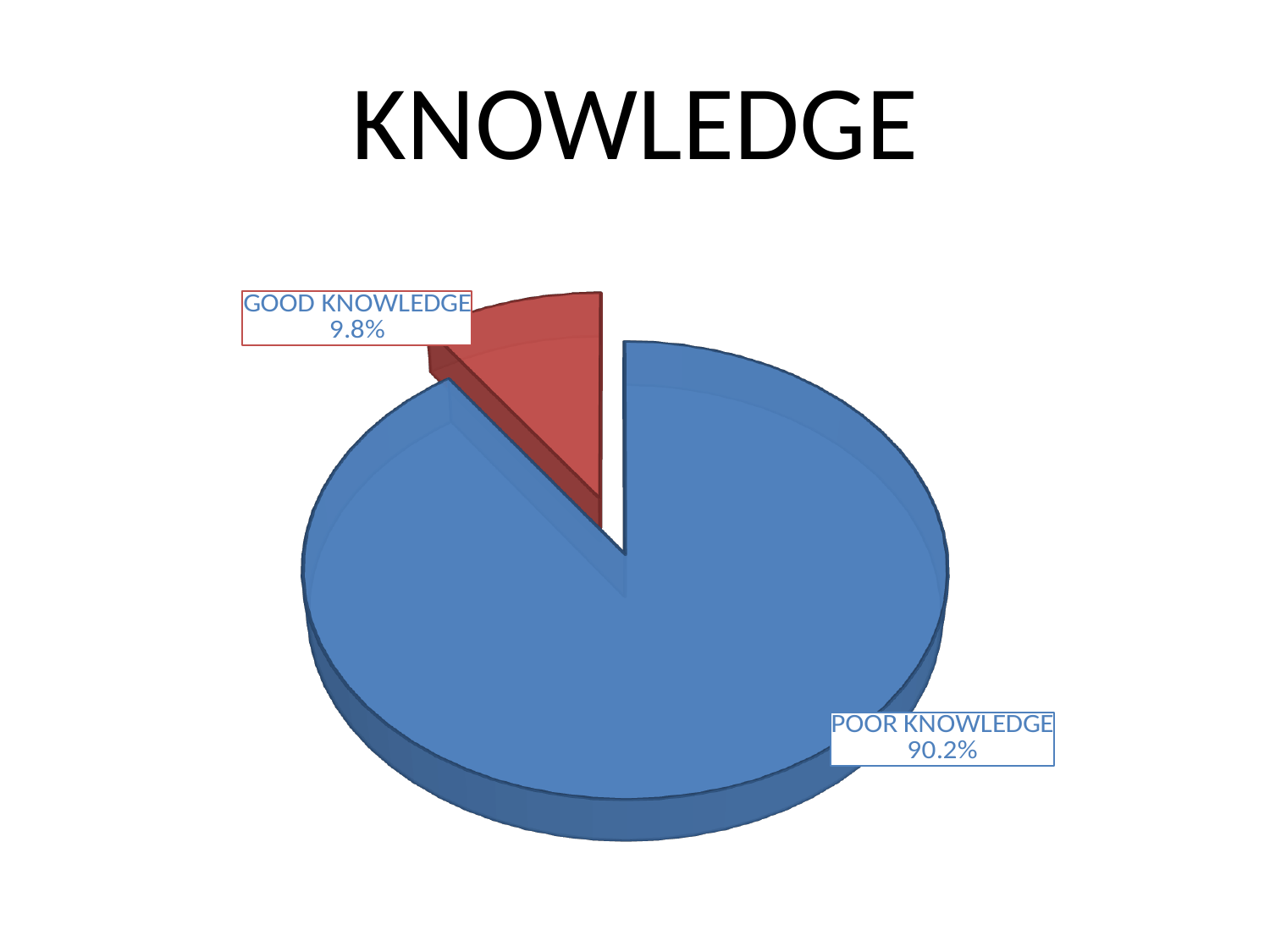
Which is larger, the GOOD KNOWLEDGE slice or the POOR KNOWLEDGE slice? POOR KNOWLEDGE What colour is the POOR KNOWLEDGE slice? blue What percentage of the pie is labelled GOOD KNOWLEDGE? 9.8% Which slice is the largest? POOR KNOWLEDGE How many slices does the pie chart have? 2 What type of chart is shown on the slide? pie chart Which slice is the smallest? GOOD KNOWLEDGE What is the difference in percentage points between POOR KNOWLEDGE and GOOD KNOWLEDGE? 80.4 What is the title of the chart? KNOWLEDGE What share of the pie does the GOOD KNOWLEDGE slice represent? 9.8% What percentage of the pie is labelled POOR KNOWLEDGE? 90.2%